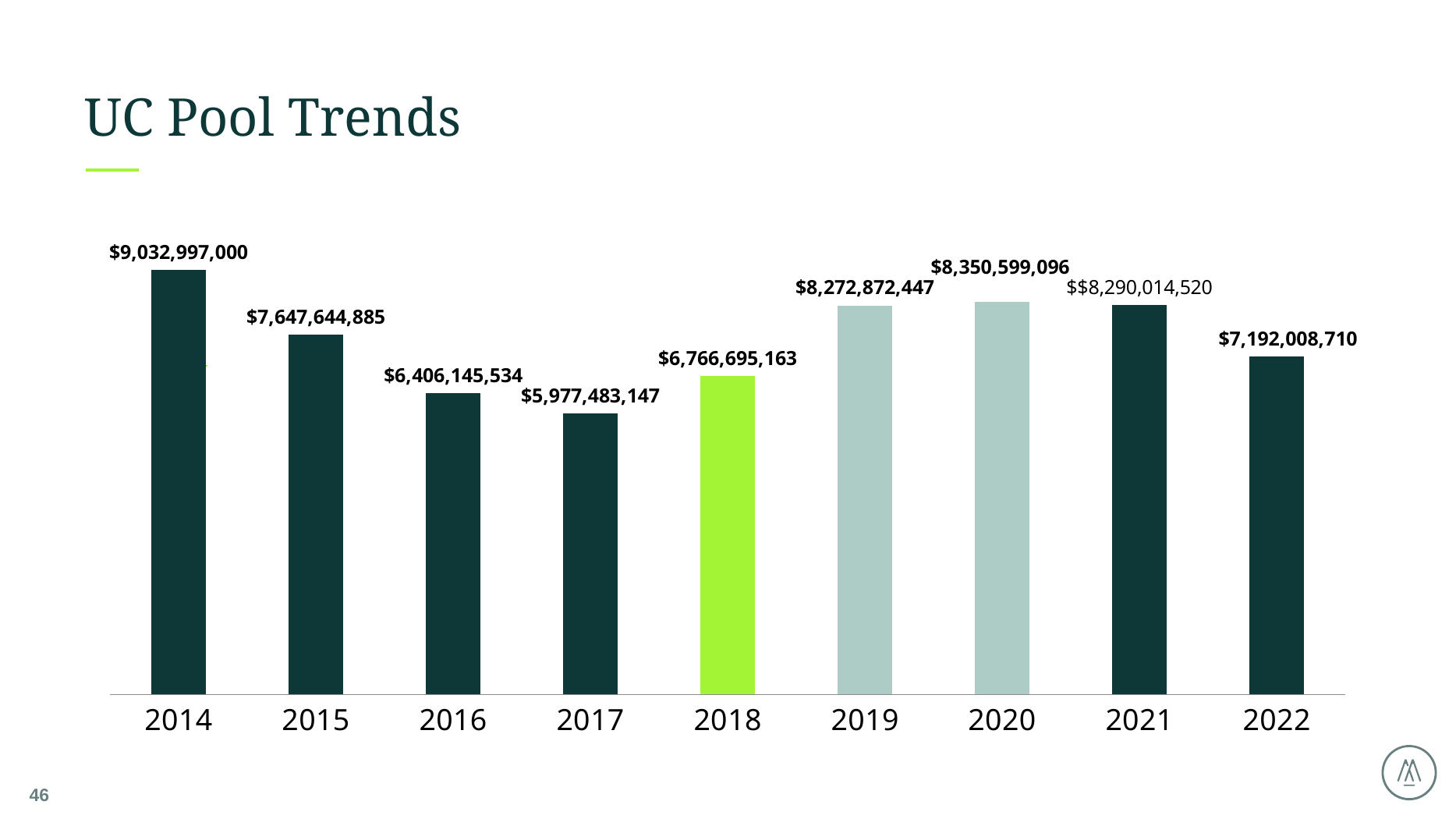
What is the value for 2014? $9,032,997,000 Which is larger, the value for 2019 or the value for 2020? 2020 What kind of chart is shown on the slide? Bar chart Which year has the highest value? 2014 What is the difference between the 2015 value and the 2016 value? $1,241,499,351 What is the value for 2022? $7,192,008,710 Which is larger, the value for 2018 or the value for 2022? 2022 How many years are shown on the x axis? 9 What is the value for 2018? $6,766,695,163 Which year has the lowest value? 2017 Do the values rise or fall from 2014 to 2017? Fall What is the difference between the 2014 value and the 2017 value? $3,055,513,853